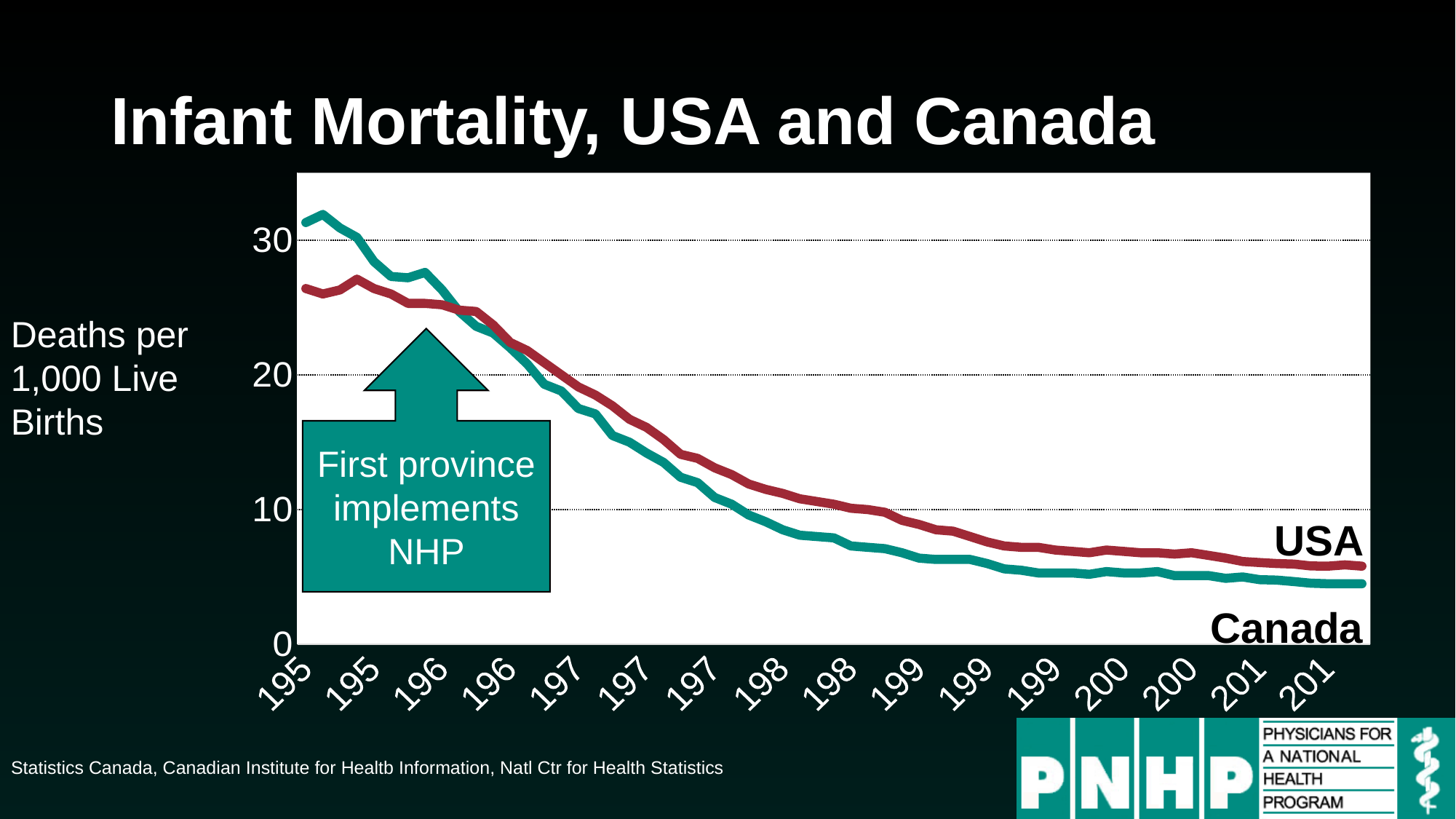
How many series are plotted on the chart? 2 What kind of chart is shown on the slide? line chart At the right end of the chart, which series has the higher value, USA or Canada? USA Which two series are plotted on the chart? USA and Canada Do the values for the USA series rise or fall along the x axis? fall Is the value for Canada at the left end of the chart greater or less than 30? greater Is the value for Canada at the right end of the chart greater or less than 10? less At the left end of the chart, which series has the higher value, USA or Canada? Canada Do the values for the Canada series rise or fall along the x axis? fall Is the value for USA at the right end of the chart greater or less than 10? less What is the title of the chart? Infant Mortality, USA and Canada